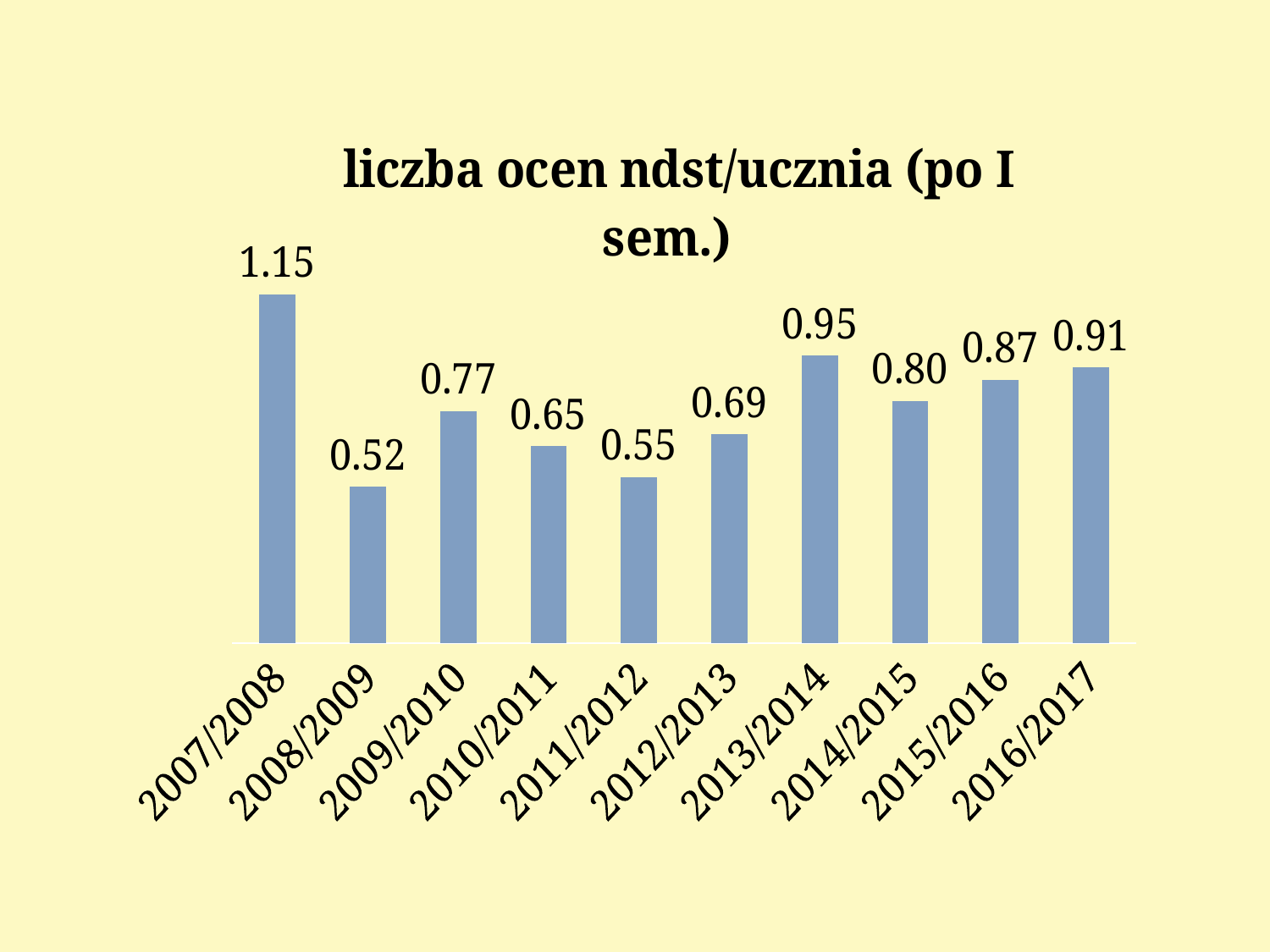
What is the value for 2011/2012? 0.55 How many school years are shown on the chart? 10 What is the difference between the values for 2016/2017 and 2015/2016? 0.04 What is the difference between the values for 2007/2008 and 2008/2009? 0.63 What is the value for 2013/2014? 0.95 What is the value for 2007/2008? 1.15 Which school year has the highest value? 2007/2008 Which is larger, the value for 2009/2010 or the value for 2010/2011? 2009/2010 What is the title of the chart? liczba ocen ndst/ucznia (po I sem.) What is the value for 2016/2017? 0.91 Which school year has the lowest value? 2008/2009 What kind of chart is this? bar chart